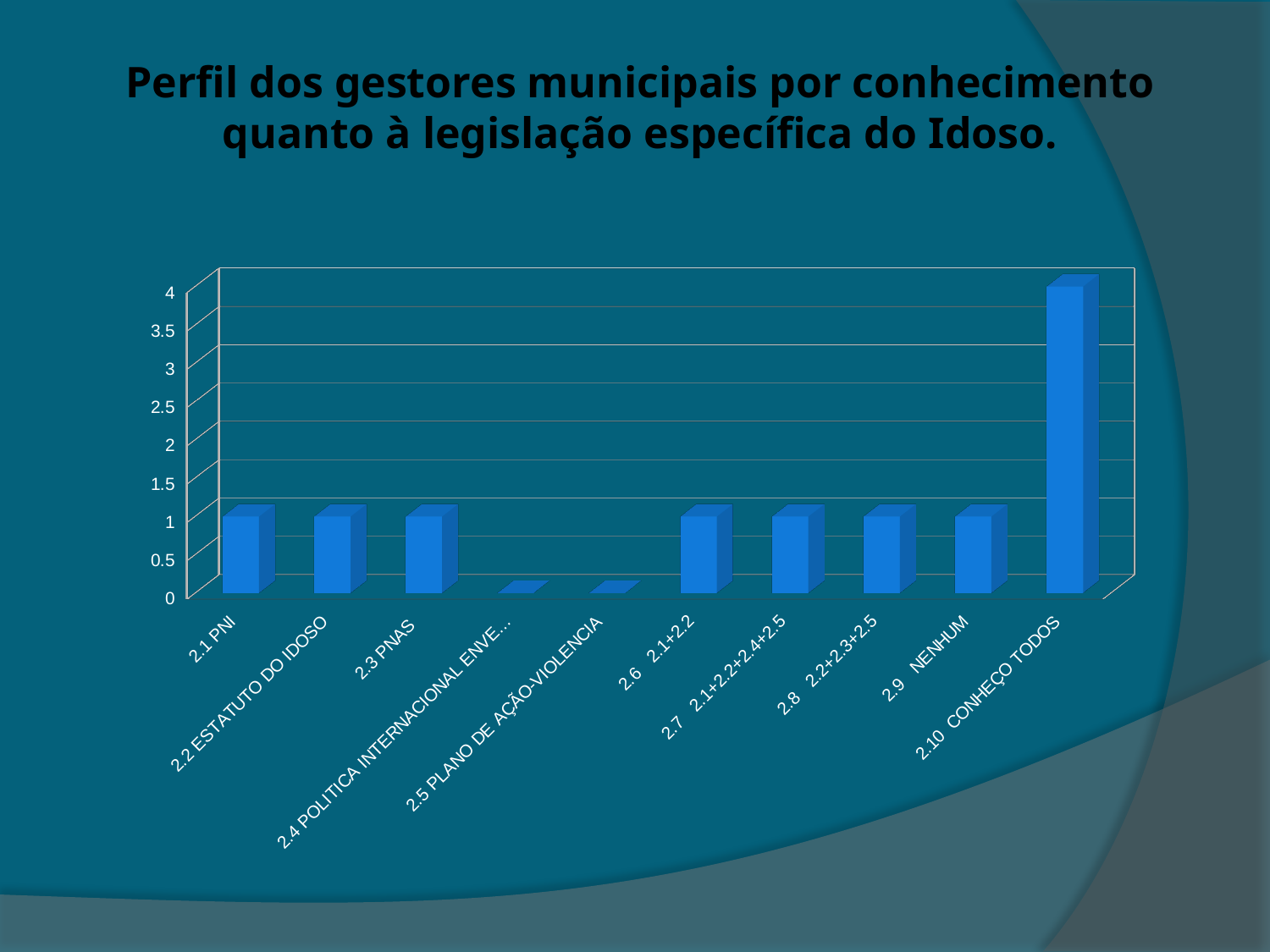
What is the value for 2.9 NENHUM? 1 How many categories are shown on the x axis of the chart? 10 What is the value for 2.10 CONHEÇO TODOS? 4 What kind of chart is shown on the slide? bar chart Which is larger, the value for 2.3 PNAS or the value for 2.10 CONHEÇO TODOS? 2.10 CONHEÇO TODOS Which category has the highest bar in the chart? 2.10 CONHEÇO TODOS What is the value for 2.1 PNI? 1 Is the value for 2.10 CONHEÇO TODOS greater or less than 3? greater What is the difference between the value for 2.10 CONHEÇO TODOS and the value for 2.2 ESTATUTO DO IDOSO? 3 How many categories in the chart have a value of 0? 2 What is the title of the slide containing the chart? Perfil dos gestores municipais por conhecimento quanto à legislação específica do Idoso. What is the value for 2.5 PLANO DE AÇÃO-VIOLENCIA? 0